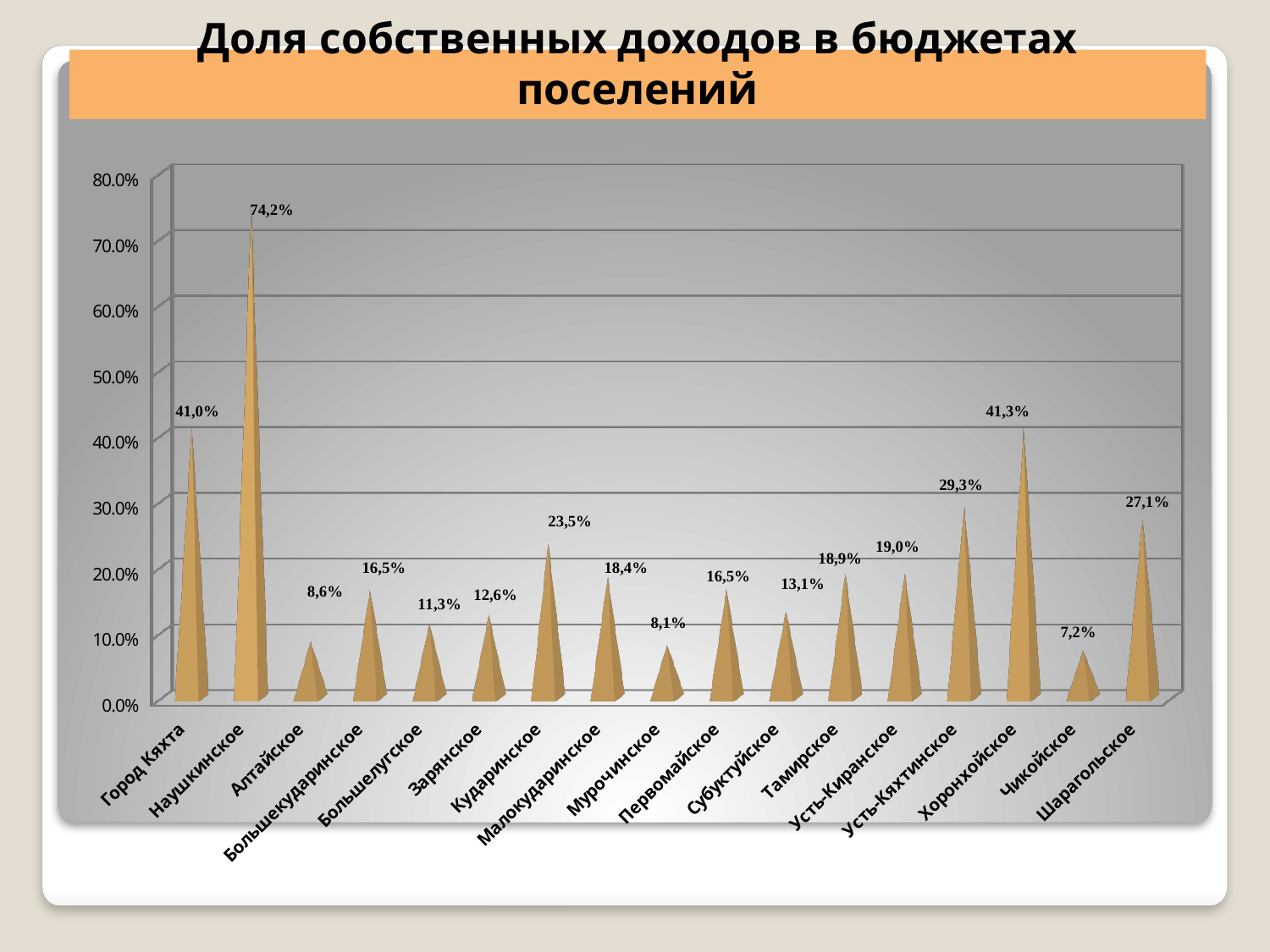
What is the value for Чикойское? 7,2% What is the title of the chart? Доля собственных доходов в бюджетах поселений Is the value for Усть-Кяхтинское greater or less than 20.0%? greater What kind of chart is shown on the slide? Bar chart How many settlements are shown on the chart? 17 Which is larger, the value for Шарагольское or the value for Кударинское? Шарагольское What is the difference between the values for Наушкинское and Хоронхойское? 32,9% Which settlement has the lowest share of own revenues? Чикойское What is the value for Наушкинское? 74,2% What is the value for Хоронхойское? 41,3% Which settlement has the highest share of own revenues? Наушкинское What is the value for Кударинское? 23,5%